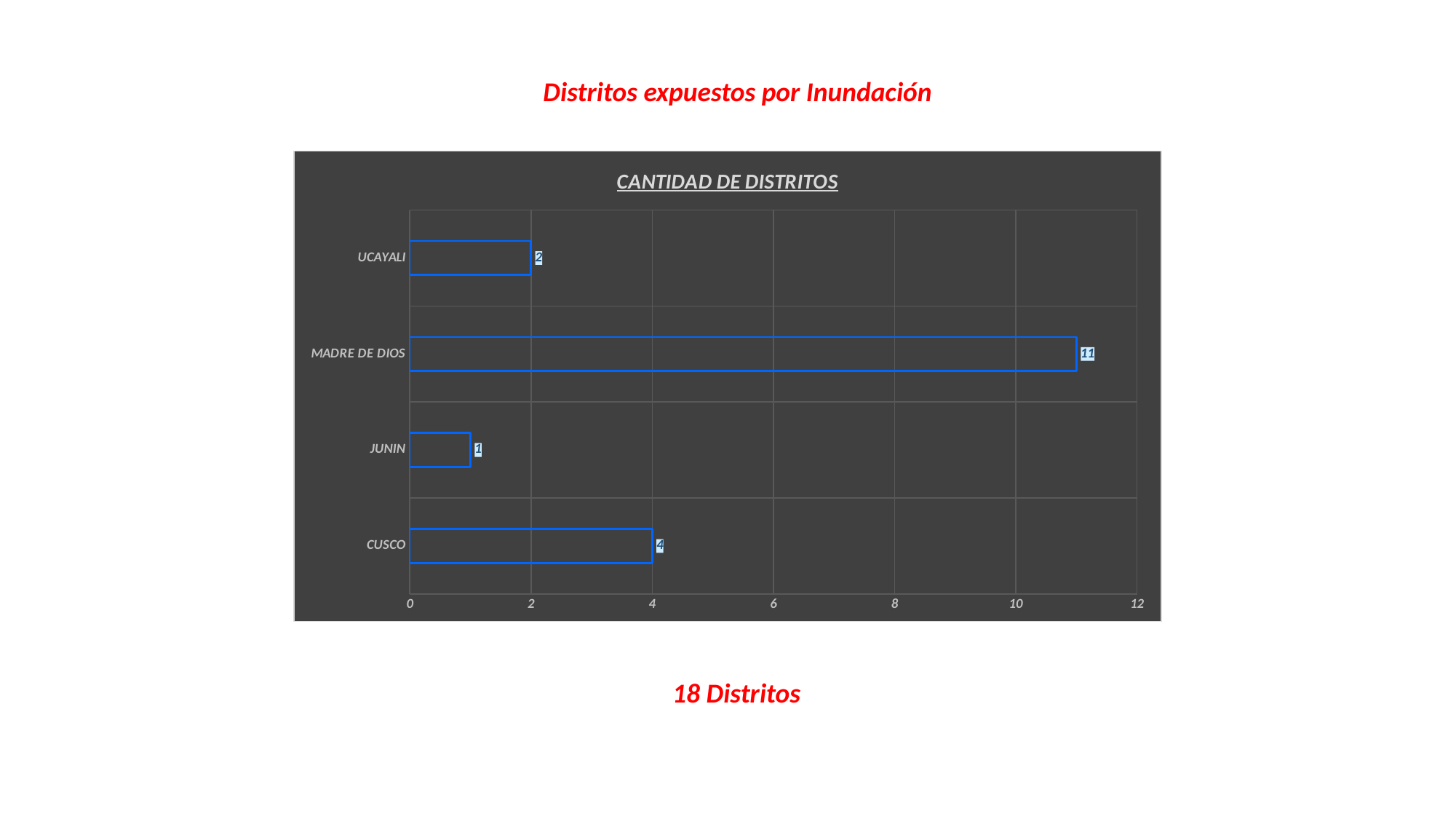
Which category has the lowest value? JUNIN How many categories are shown in the chart? 4 Which is larger, the value for CUSCO or the value for UCAYALI? CUSCO What is the value for CUSCO? 4 What is the value for JUNIN? 1 What is the difference between the values for MADRE DE DIOS and CUSCO? 7 What kind of chart is shown? bar chart Is the value for MADRE DE DIOS greater or less than 10? greater What is the value for MADRE DE DIOS? 11 Which category has the highest value? MADRE DE DIOS What is the title of the chart? CANTIDAD DE DISTRITOS What is the value for UCAYALI? 2